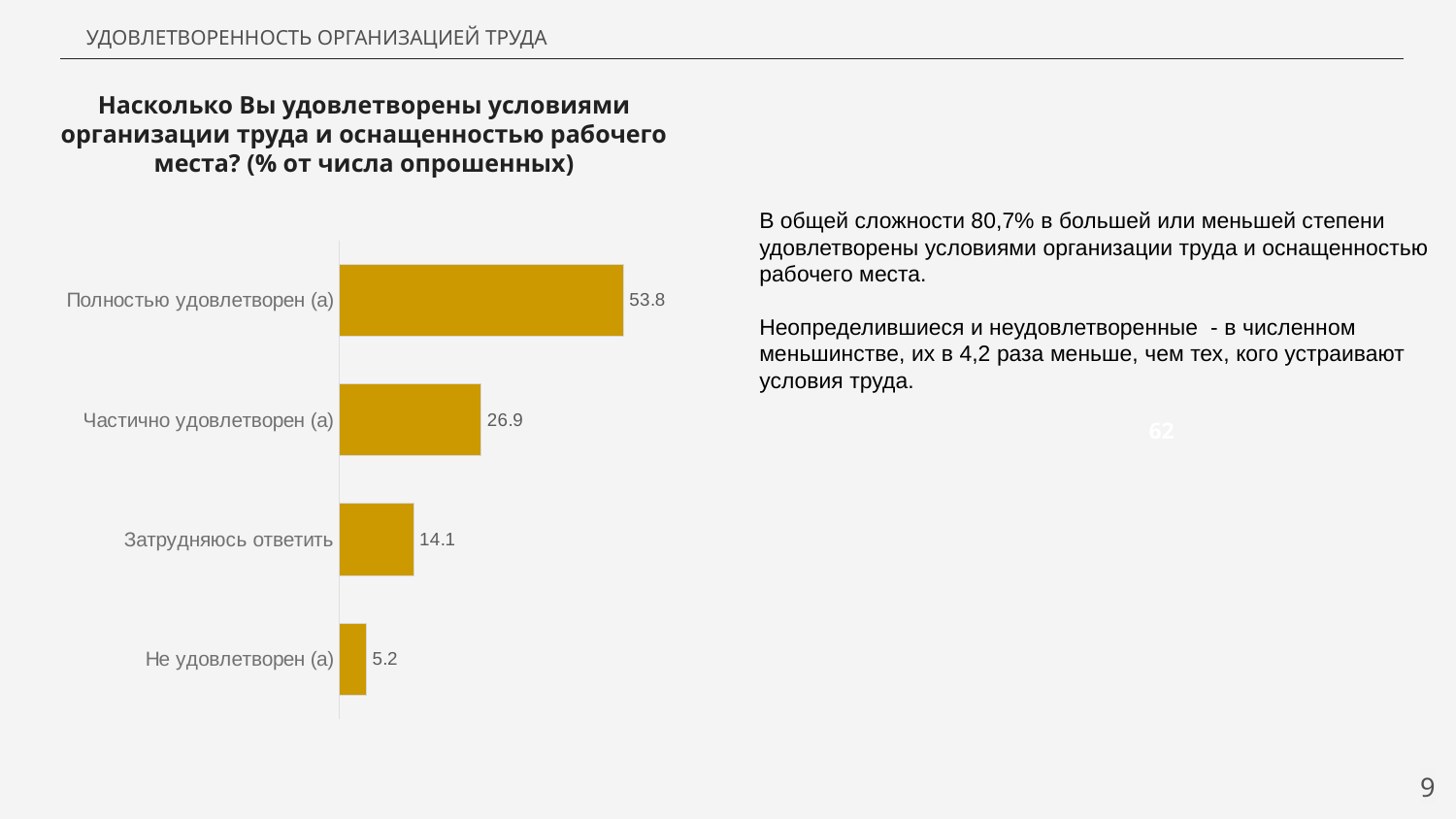
What is the title of the chart? Насколько Вы удовлетворены условиями организации труда и оснащенностью рабочего места? (% от числа опрошенных) What is the value for "Затрудняюсь ответить"? 14.1 What is the value for "Не удовлетворен (а)"? 5.2 What is the value for "Полностью удовлетворен (а)"? 53.8 Which is larger, the value for "Частично удовлетворен (а)" or "Затрудняюсь ответить"? Частично удовлетворен (а) Which category has the lowest value? Не удовлетворен (а) What is the difference between the values for "Затрудняюсь ответить" and "Не удовлетворен (а)"? 8.9 What is the difference between the values for "Полностью удовлетворен (а)" and "Частично удовлетворен (а)"? 26.9 What kind of chart is shown on the slide? Bar chart What is the value for "Частично удовлетворен (а)"? 26.9 How many categories are shown in the chart? 4 Which category has the highest value? Полностью удовлетворен (а)